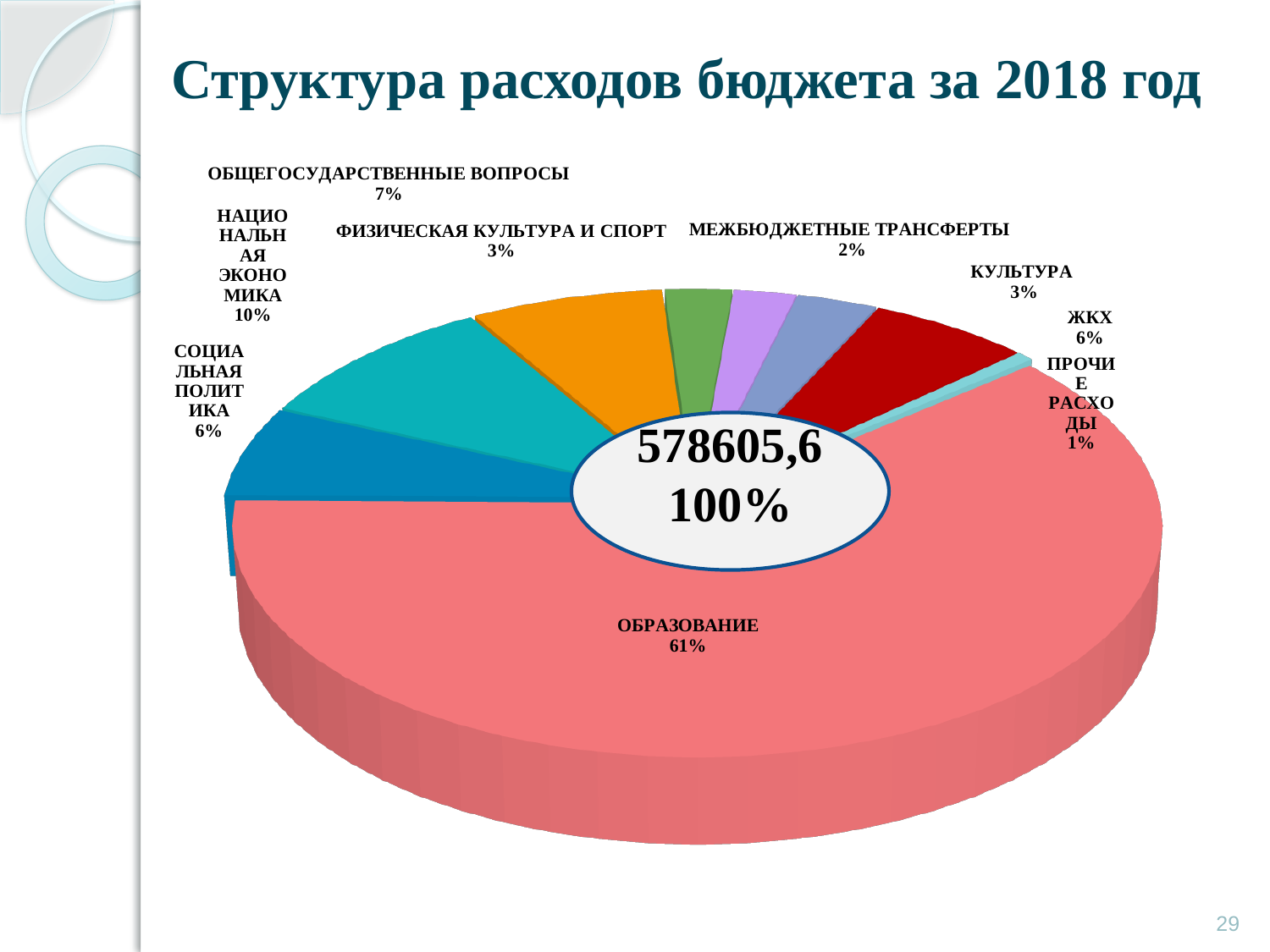
What is the title of the chart on the slide? Структура расходов бюджета за 2018 год How many categories are shown in the pie chart? 9 Which is larger, the share for ЖКХ or the share for КУЛЬТУРА? ЖКХ Which category has the smallest share of the pie? ПРОЧИЕ РАСХОДЫ What percentage is shown for ОБЩЕГОСУДАРСТВЕННЫЕ ВОПРОСЫ? 7% What share of the pie does ОБРАЗОВАНИЕ account for? 61% What percentage is shown for МЕЖБЮДЖЕТНЫЕ ТРАНСФЕРТЫ? 2% What percentage is shown for НАЦИОНАЛЬНАЯ ЭКОНОМИКА? 10% What kind of chart is shown on the slide? Pie chart What is the difference in percentage points between ОБРАЗОВАНИЕ and НАЦИОНАЛЬНАЯ ЭКОНОМИКА? 51 What total value is printed in the centre of the pie chart? 578605,6 Which category has the largest share of the pie? ОБРАЗОВАНИЕ